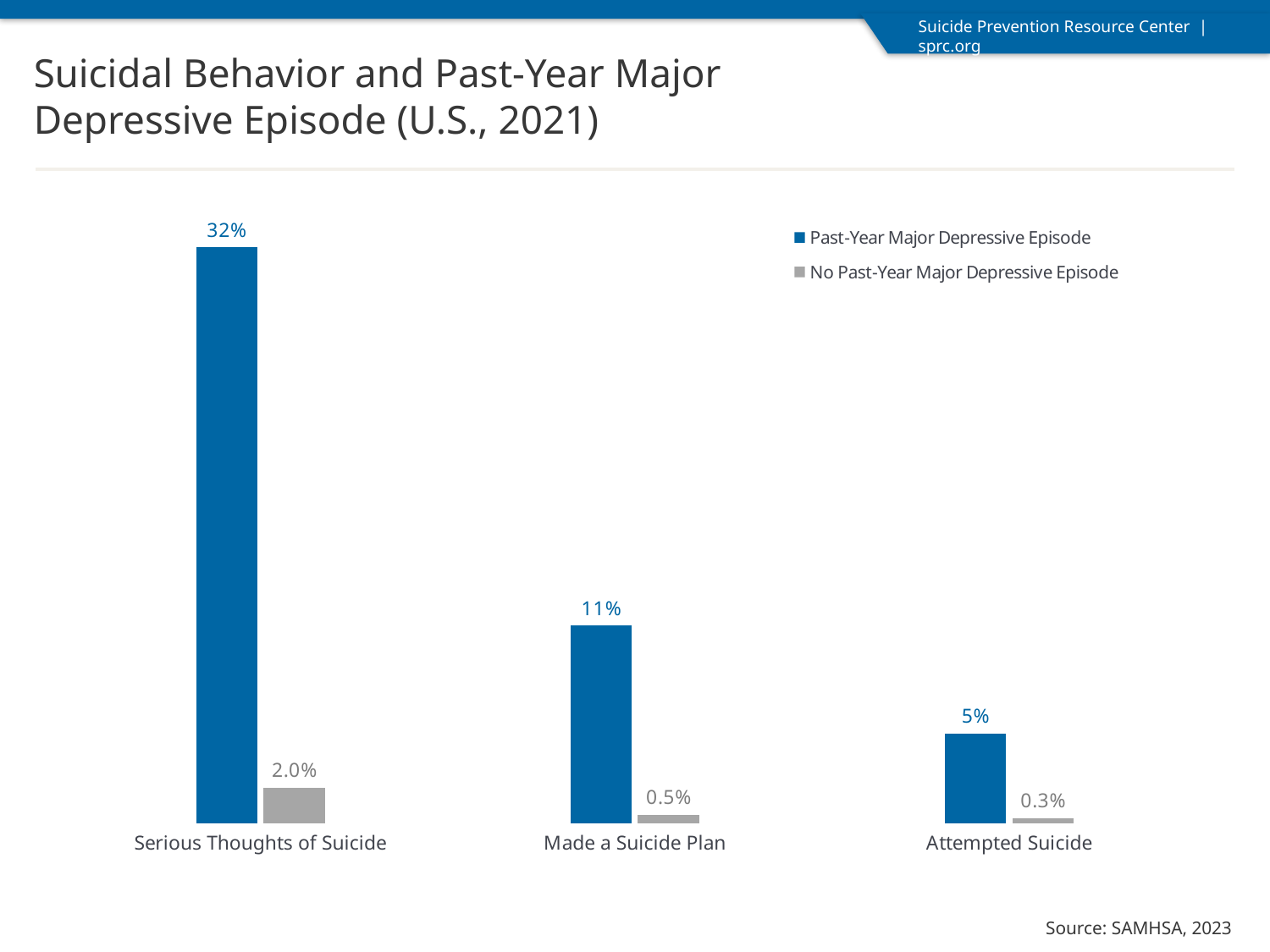
How many series does the legend list? 2 How many categories are shown on the x axis? 3 What is the source cited for the chart? SAMHSA, 2023 Which category has the lowest value for the No Past-Year Major Depressive Episode series? Attempted Suicide What is the value for Serious Thoughts of Suicide among those with a Past-Year Major Depressive Episode? 32% Which category has the highest value for the Past-Year Major Depressive Episode series? Serious Thoughts of Suicide What is the value for Attempted Suicide among those with a Past-Year Major Depressive Episode? 5% What is the value for Serious Thoughts of Suicide among those with No Past-Year Major Depressive Episode? 2.0% What is the difference between the Past-Year Major Depressive Episode value and the No Past-Year Major Depressive Episode value for Made a Suicide Plan? 10.5% Which is larger: the Past-Year Major Depressive Episode value for Made a Suicide Plan or for Attempted Suicide? Made a Suicide Plan What is the value for Made a Suicide Plan among those with No Past-Year Major Depressive Episode? 0.5% What kind of chart is shown on the slide? Bar chart